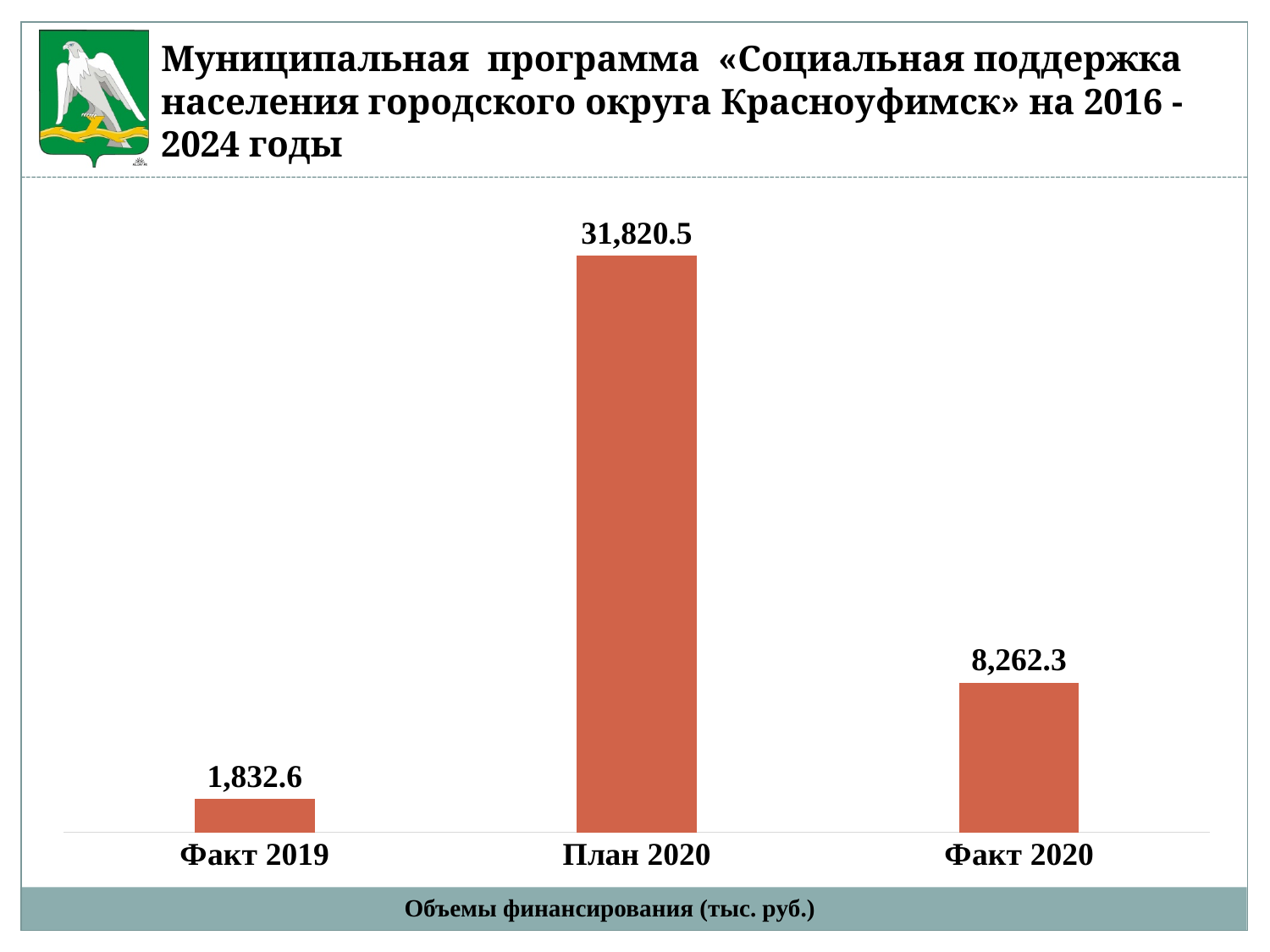
Which category has the highest value? План 2020 What is the difference between the values for Факт 2020 and Факт 2019? 6,429.7 Which category has the lowest value? Факт 2019 Does the value rise or fall from План 2020 to Факт 2020? Fall What is the value for Факт 2019? 1,832.6 What is the value for Факт 2020? 8,262.3 Which is larger, the value for Факт 2020 or the value for Факт 2019? Факт 2020 What kind of chart is shown on the slide? Bar chart How many categories are shown in the chart? 3 What is the difference between the values for План 2020 and Факт 2020? 23,558.2 What unit is given in the chart caption at the bottom of the slide? тыс. руб. What is the value for План 2020? 31,820.5